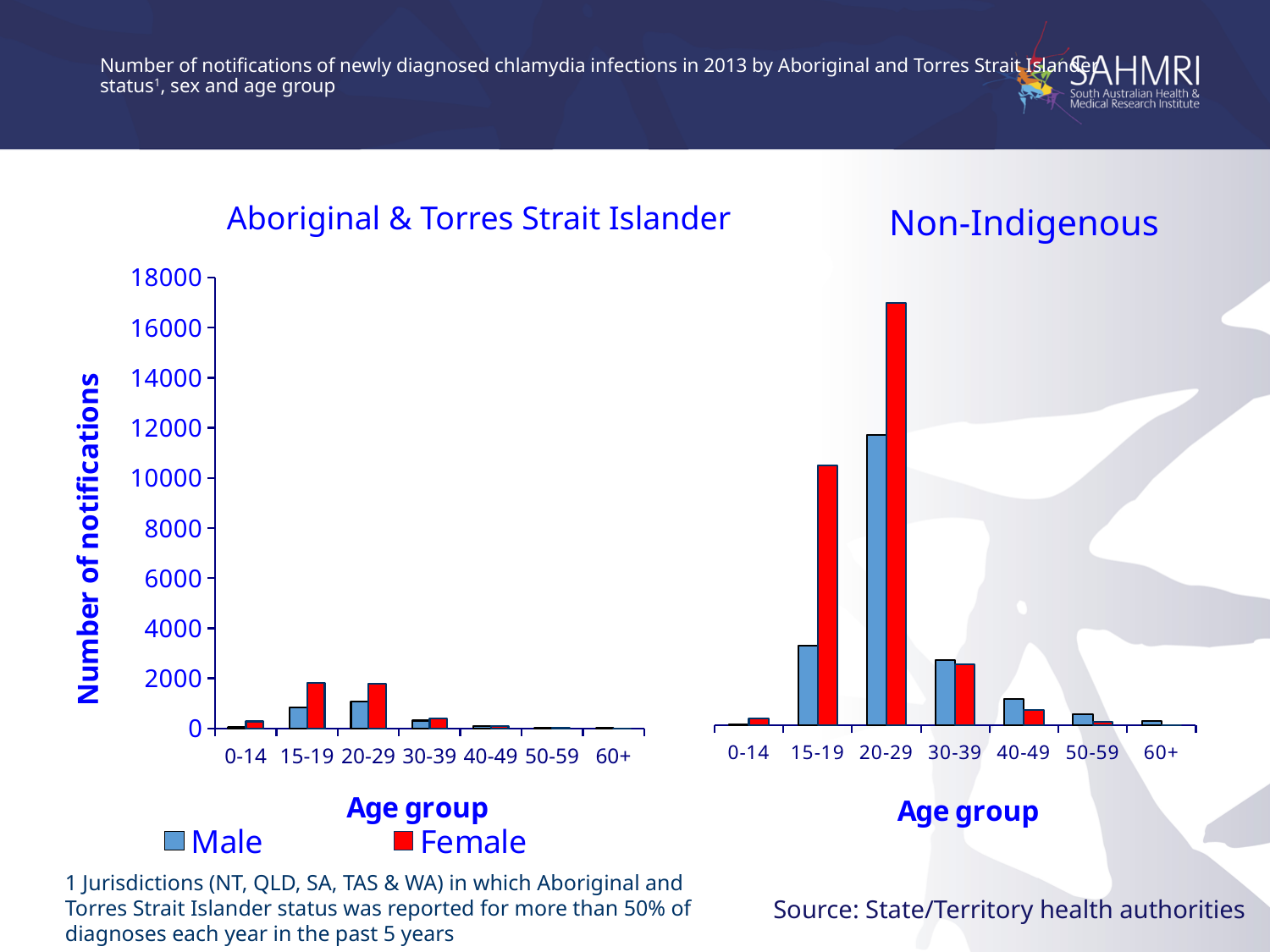
What kind of chart is the Aboriginal & Torres Strait Islander chart? Bar chart How many age group categories are shown on the x axis of the Non-Indigenous chart? 7 In the Non-Indigenous chart, which age group has the highest Female bar? 20-29 In the Non-Indigenous chart, is the Male value for 20-29 greater or less than 10000? greater In the Non-Indigenous chart, do the values rise or fall from the 20-29 age group to the 60+ age group? Fall In the Aboriginal & Torres Strait Islander chart, which age group has the highest Male bar? 20-29 How many series does the legend list? 2 In the Non-Indigenous chart, which age group has the highest Male bar? 20-29 In the Non-Indigenous chart, is the Female value for 20-29 greater or less than 16000? greater Which colour represents Female in the legend? Red In the Non-Indigenous chart, which is larger for the 15-19 age group, Male or Female? Female